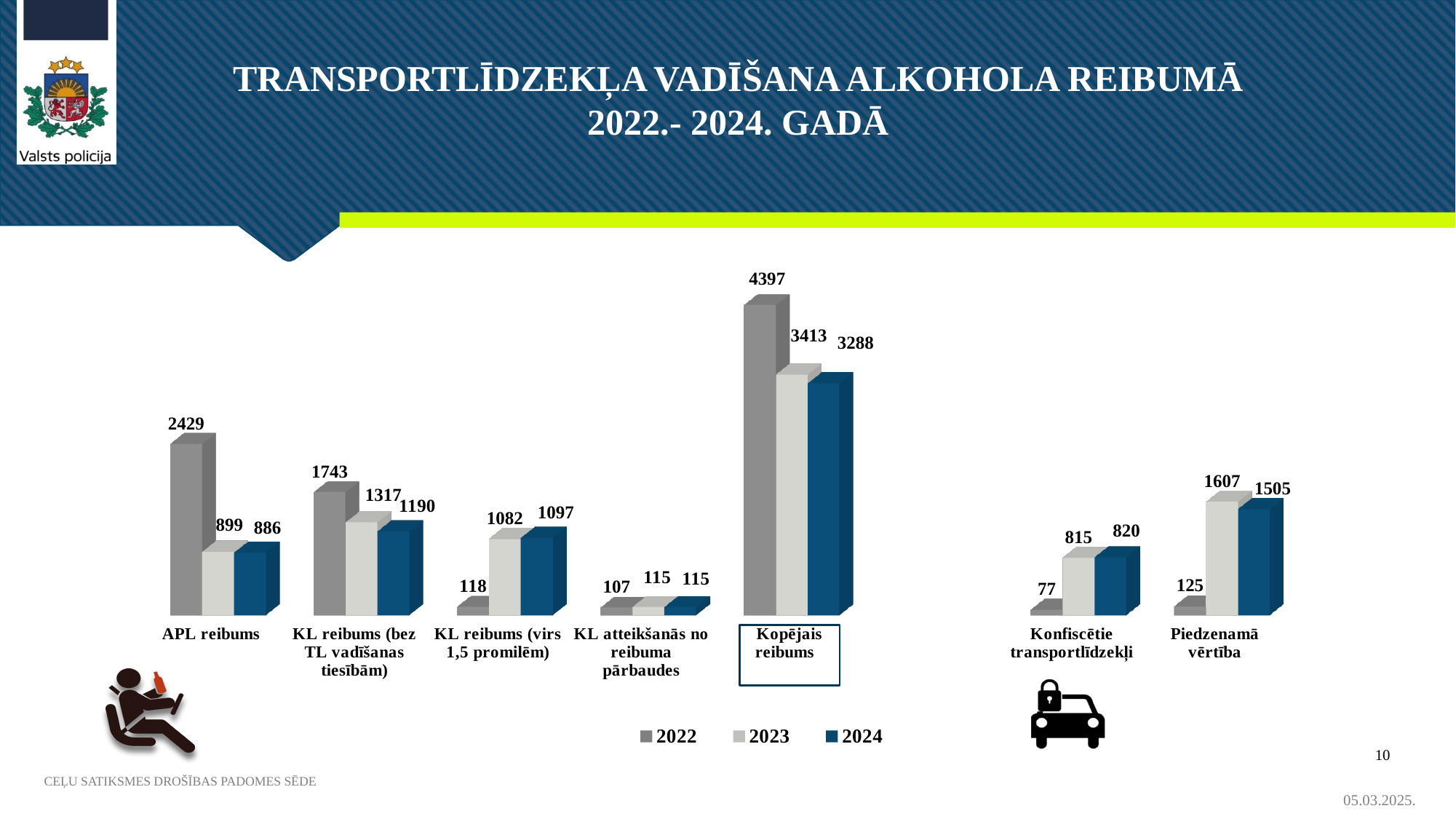
How many categories are shown on the x axis of the chart? 7 Which category has the lowest value in the 2022 series? Konfiscētie transportlīdzekļi Do the values for APL reibums rise or fall from 2022 to 2024? Fall Which is larger for KL reibums (virs 1,5 promilēm): the 2023 value or the 2024 value? 2024 What is the difference between the 2022 and 2024 values for Kopējais reibums? 1109 What is the value for Konfiscētie transportlīdzekļi in 2023? 815 What is the value for Kopējais reibums in 2024? 3288 What is the value for APL reibums in 2022? 2429 Which category has the highest value in the 2022 series? Kopējais reibums How many series does the legend list? 3 What is the value for Piedzenamā vērtība in 2022? 125 What kind of chart is shown on the slide? Bar chart